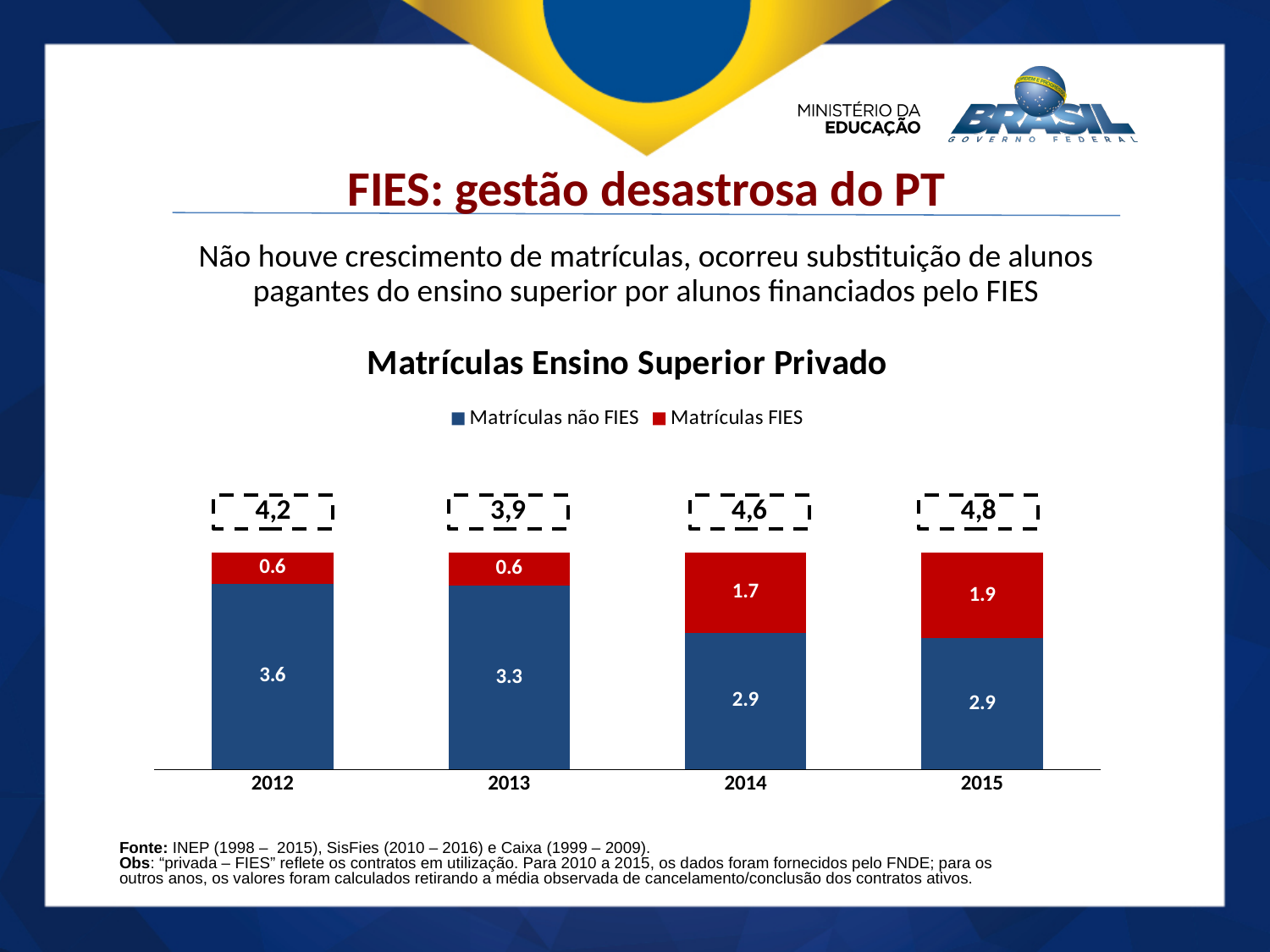
What is the value for Matrículas não FIES in 2012? 3.6 How many series does the legend list? 2 What is the difference between Matrículas não FIES in 2012 and in 2015? 0.7 What is the value for Matrículas FIES in 2014? 1.7 What is the total shown above the stacked bar for 2014? 4,6 What is the value for Matrículas não FIES in 2013? 3.3 What kind of chart is shown on the slide? Stacked bar chart Is the value for Matrículas FIES larger in 2013 or in 2014? 2014 What is the total shown above the stacked bar for 2013? 3,9 Which year has the lowest value for Matrículas não FIES? 2014 and 2015 (both 2.9) What is the value for Matrículas FIES in 2015? 1.9 Which year has the highest value for Matrículas FIES? 2015